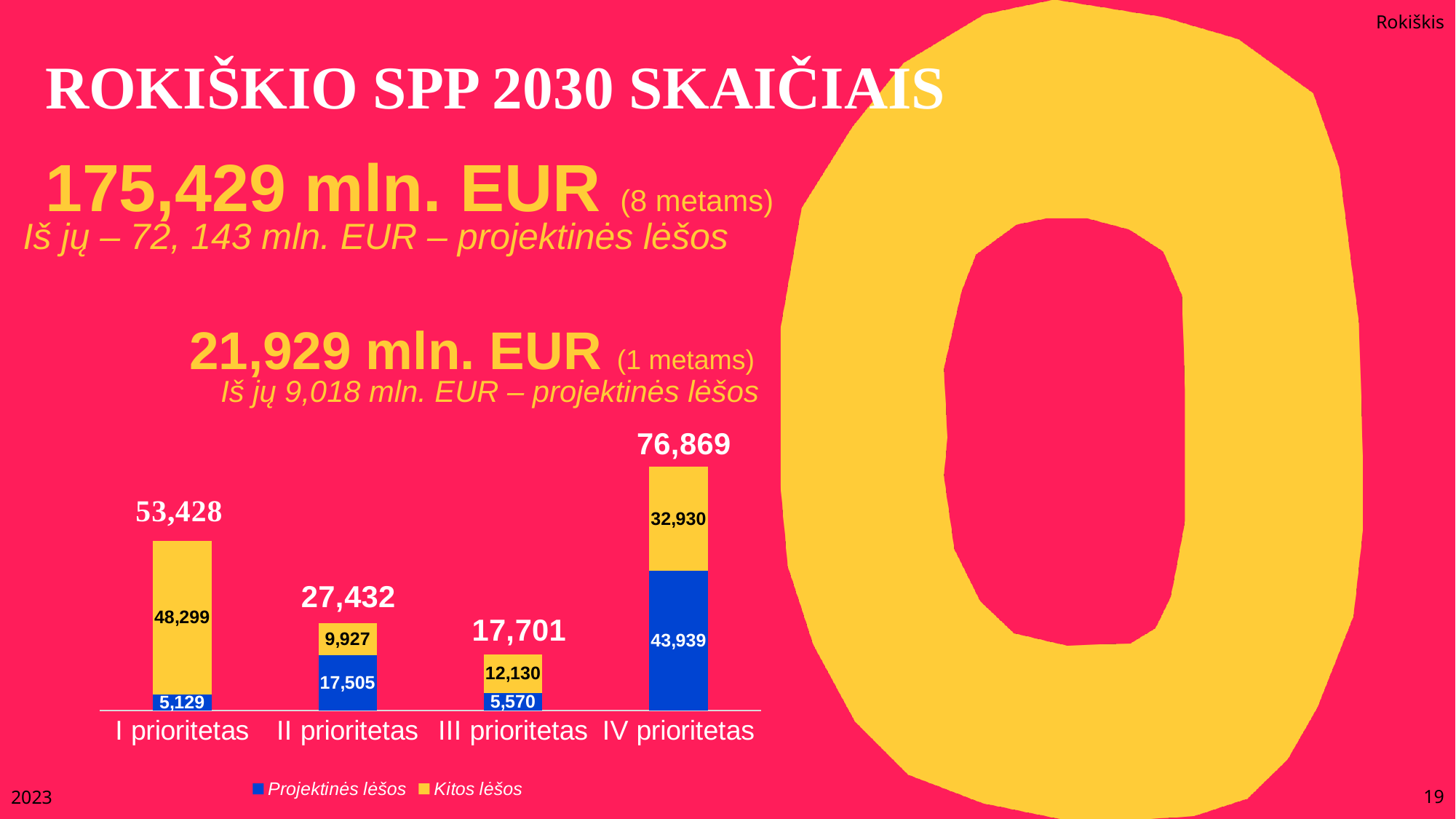
How many categories (priorities) are shown on the x axis of the chart? 4 What type of chart is shown on the slide? Stacked bar chart Which is larger: Projektinės lėšos for II prioritetas or Projektinės lėšos for III prioritetas? II prioritetas What is the value of Projektinės lėšos for I prioritetas? 5,129 What is the value of Kitos lėšos for II prioritetas? 9,927 What is the total of the stacked bar for III prioritetas? 17,701 Which colour represents Kitos lėšos in the chart? Yellow What is the value of Projektinės lėšos for IV prioritetas? 43,939 How many series does the chart legend list? 2 Which priority has the lowest total bar? III prioritetas Which priority has the highest total bar? IV prioritetas What is the difference between the total for IV prioritetas and the total for I prioritetas? 23,441